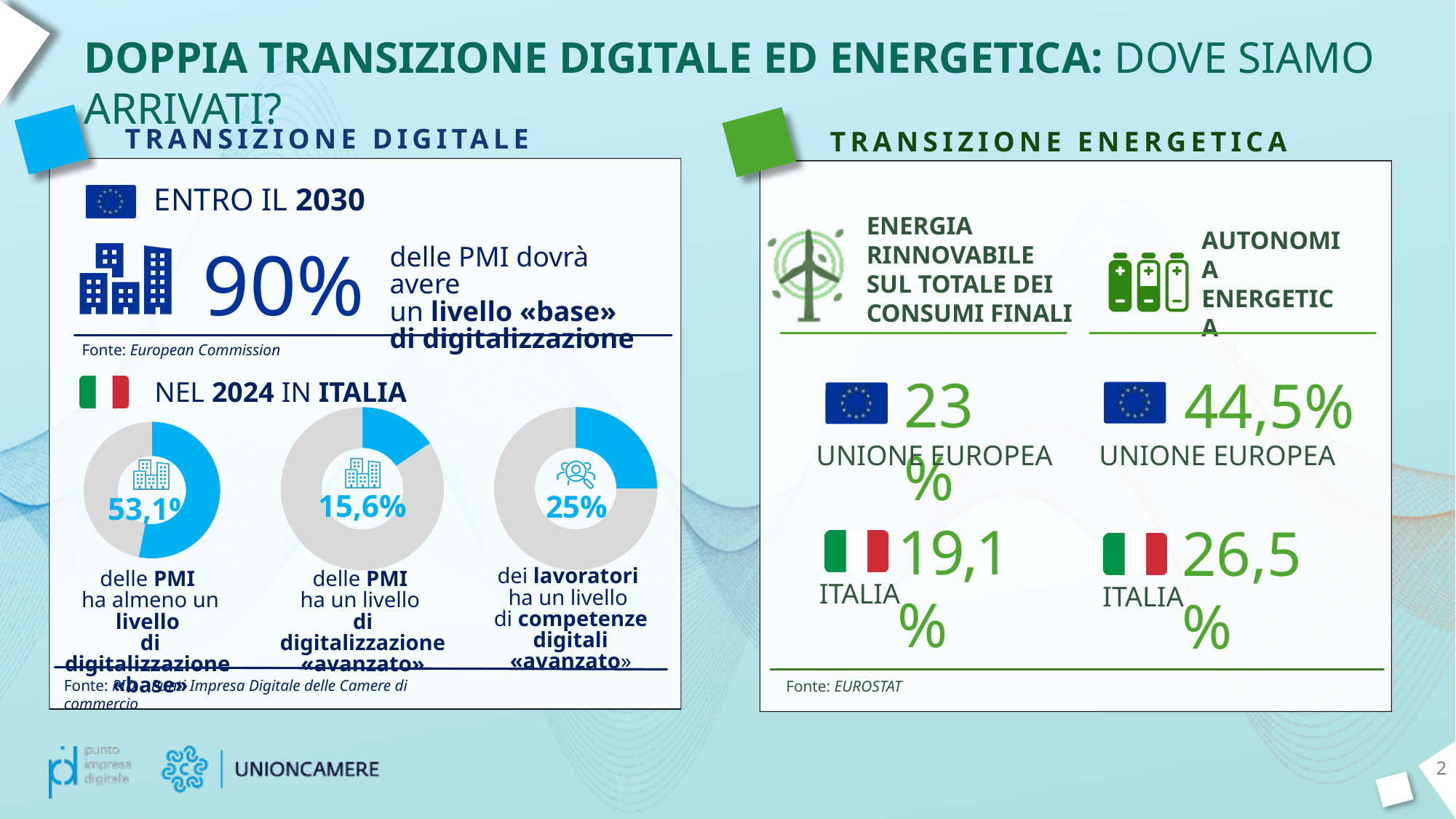
What colour is used for the highlighted slice in the three pie charts? blue In the middle pie chart, what share of PMI has an 'avanzato' level of digitalisation? 15,6% What kind of charts are the three charts under 'NEL 2024 IN ITALIA'? pie charts (donut) Which is larger: the share of PMI with an 'avanzato' digitalisation level or the share of lavoratori with 'avanzato' digital skills? lavoratori with 'avanzato' digital skills (25%) How many pie charts are shown in the 'Transizione digitale' panel? 3 In the right pie chart, what share of lavoratori has an 'avanzato' level of digital skills? 25% Which year do the three pie charts refer to? 2024 In the right pie chart, what share is represented by the grey (non-highlighted) portion? 75% In the left pie chart, is the highlighted share of PMI with at least a 'base' digitalisation level greater or less than 50%? greater Which of the three pie charts shows the highest highlighted share? delle PMI ha almeno un livello di digitalizzazione «base» (53,1%) What is the difference between the share of lavoratori with 'avanzato' digital skills (25%) and the share of PMI with an 'avanzato' digitalisation level (15,6%)? 9,4% Which of the three pie charts shows the lowest highlighted share? delle PMI ha un livello di digitalizzazione «avanzato» (15,6%)